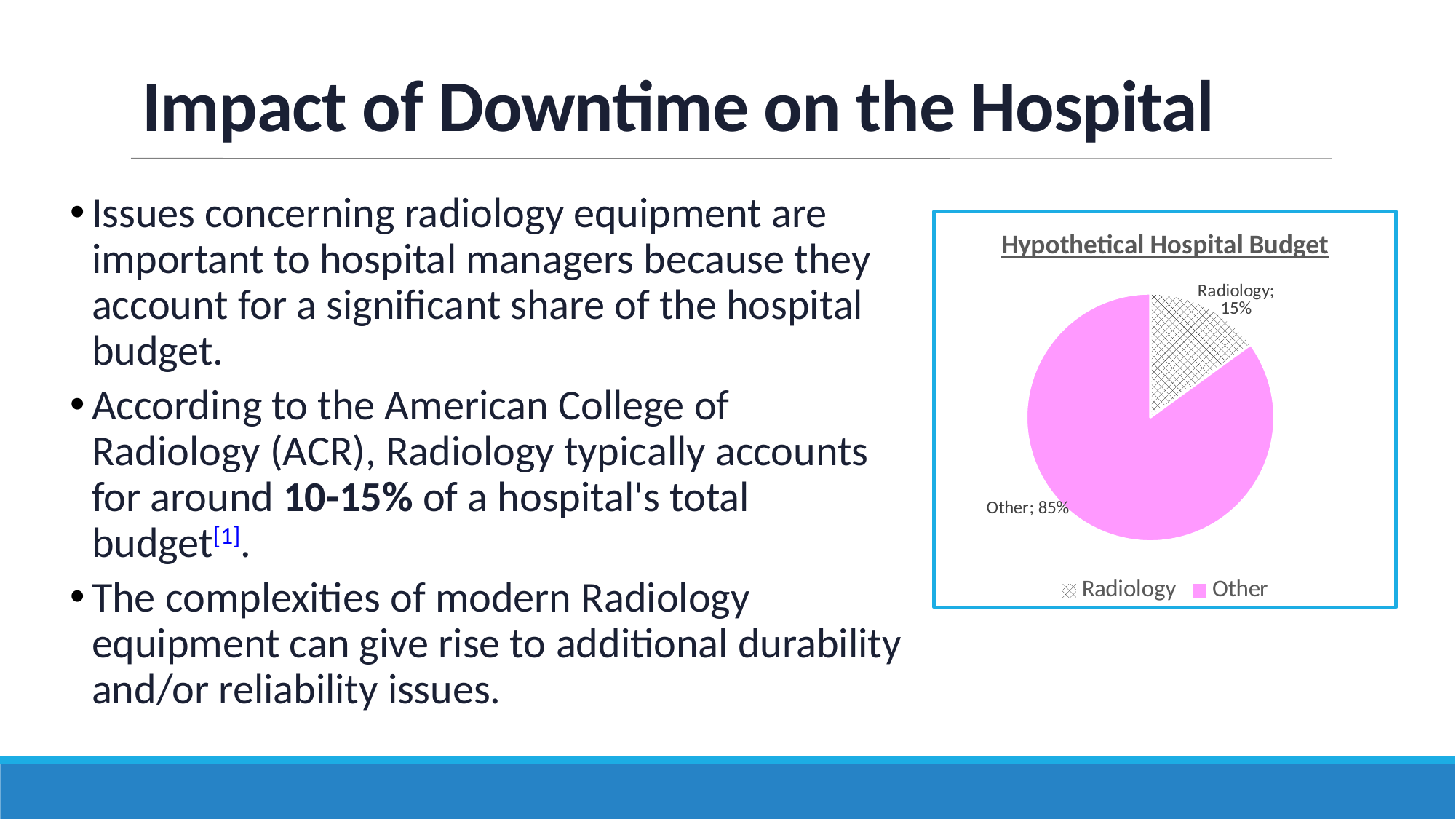
Which slice of the pie is the largest? Other What is the difference in percentage points between the Other slice and the Radiology slice? 70 Which slice of the pie is the smallest? Radiology What share of the hypothetical hospital budget is labelled Other? 85% How many entries does the legend list? 2 Which is larger, the Radiology slice or the Other slice? Other What kind of chart is shown on the slide? pie chart What share of the hypothetical hospital budget does Radiology account for? 15% How many slices does the pie chart have? 2 What is the title of the chart? Hypothetical Hospital Budget Which slice is shown with a crosshatch pattern rather than a solid fill? Radiology